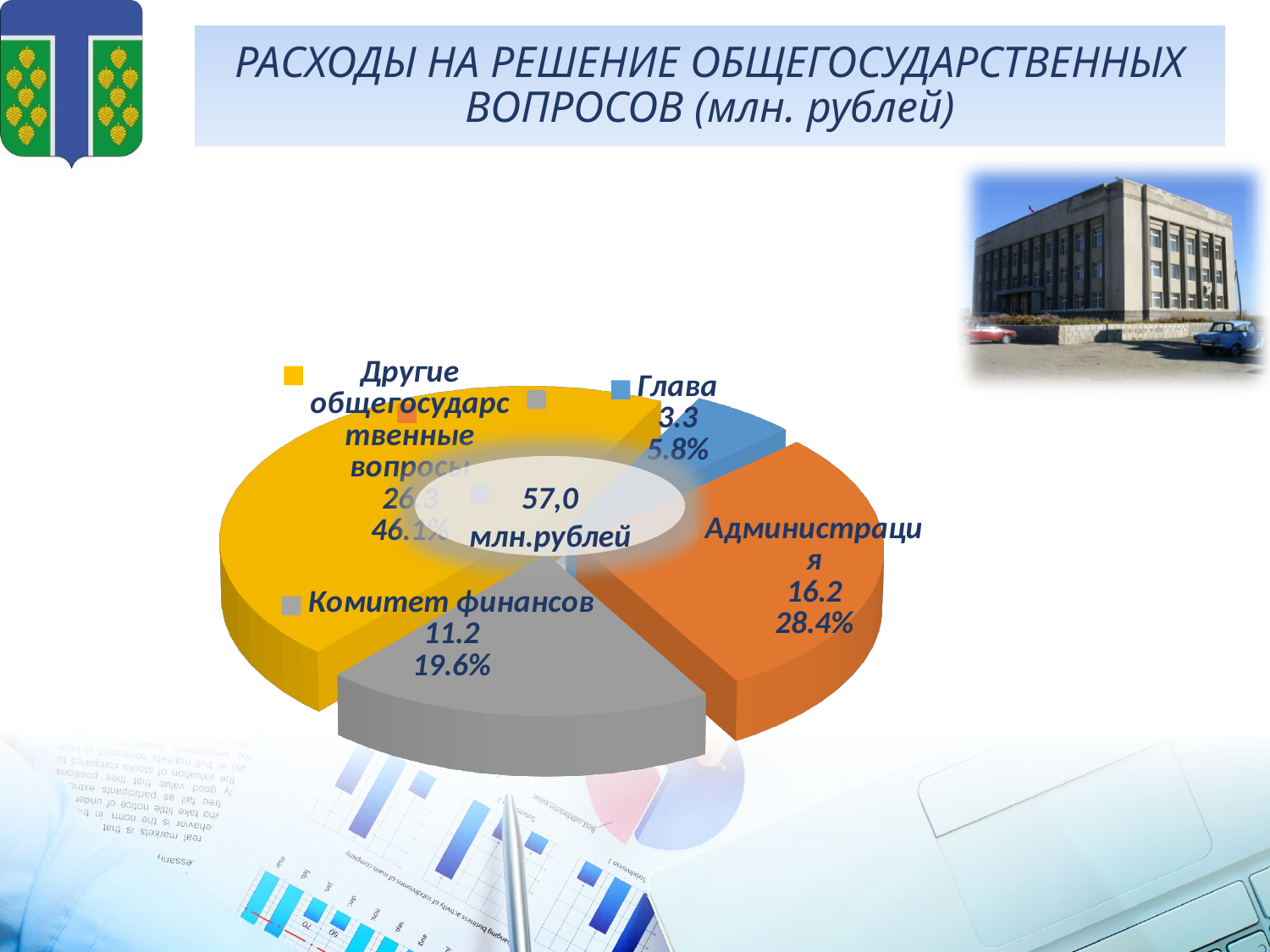
What is the value for Администрация in the pie chart? 16.2 How many slices does the pie chart have? 4 What is the difference between the values for Администрация and Комитет финансов? 5.0 What percentage share does Другие общегосударственные вопросы have in the pie chart? 46.1% What kind of chart is shown on the slide? pie chart What total amount is shown in the centre of the pie chart? 57,0 млн.рублей Which category has the largest slice in the pie chart? Другие общегосударственные вопросы Which category has the smallest slice in the pie chart? Глава What is the value for Глава in the pie chart? 3.3 Which is larger, the value for Администрация or the value for Комитет финансов? Администрация What percentage share does Комитет финансов have in the pie chart? 19.6% What colour is the slice for Администрация? orange